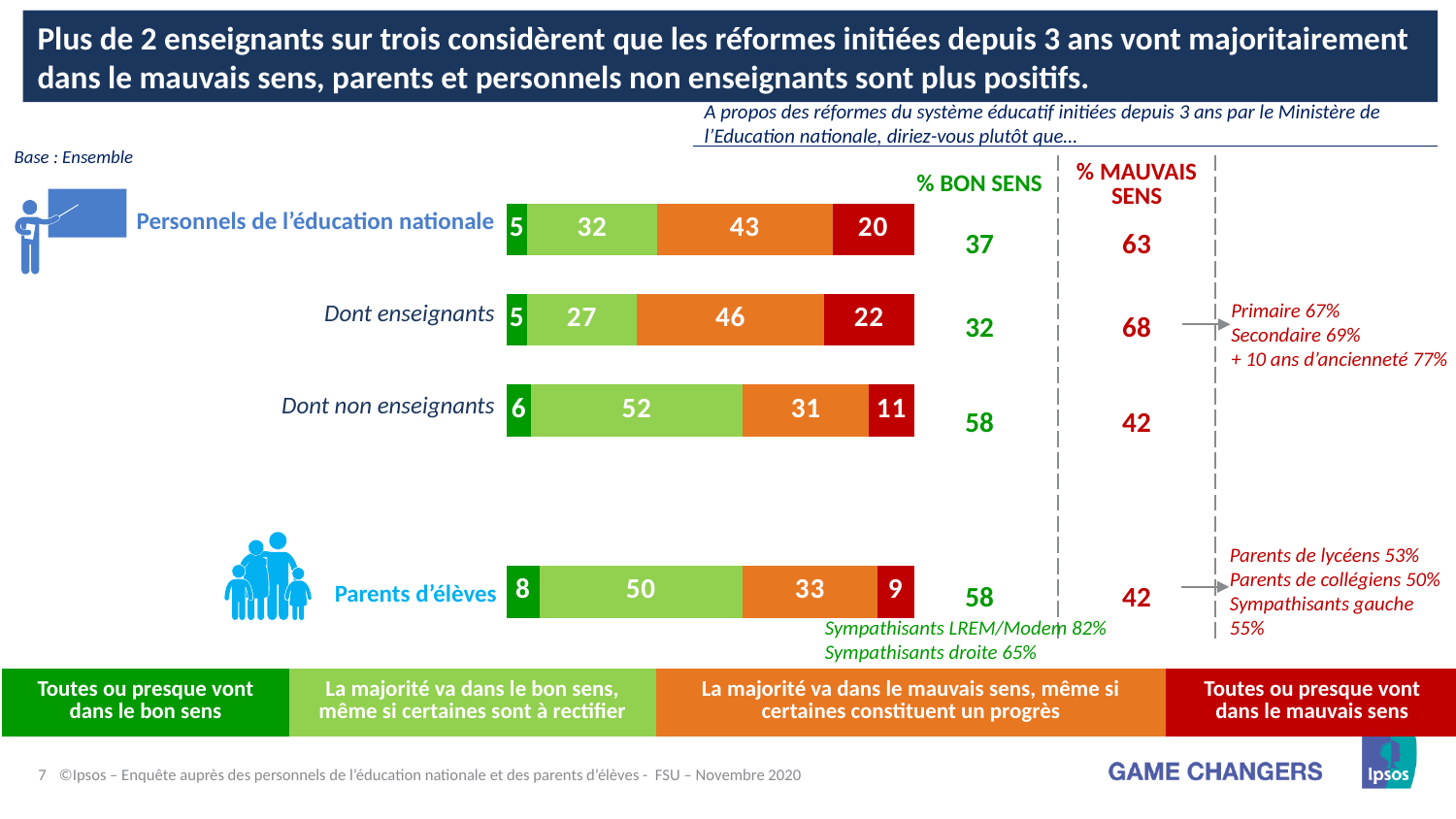
Which category has the highest value for 'Toutes ou presque vont dans le mauvais sens'? Dont enseignants What colour represents 'Toutes ou presque vont dans le mauvais sens' in the chart? Red What is the value of 'Toutes ou presque vont dans le bon sens' for 'Parents d'élèves'? 8 What is the value of 'La majorité va dans le mauvais sens, même si certaines constituent un progrès' for 'Dont enseignants'? 46 What is the '% MAUVAIS SENS' value for 'Dont enseignants'? 68 Which is larger: the 'La majorité va dans le mauvais sens' value for 'Personnels de l'éducation nationale' or for 'Parents d'élèves'? Personnels de l'éducation nationale What type of chart is shown on the slide? Stacked bar chart What is the difference between the '% MAUVAIS SENS' values for 'Personnels de l'éducation nationale' and 'Parents d'élèves'? 21 What is the value of 'La majorité va dans le bon sens, même si certaines sont à rectifier' for 'Dont non enseignants'? 52 Which category has the lowest '% BON SENS' value? Dont enseignants How many categories (groups) are plotted in the chart? 4 How many series does the legend at the bottom of the chart list? 4